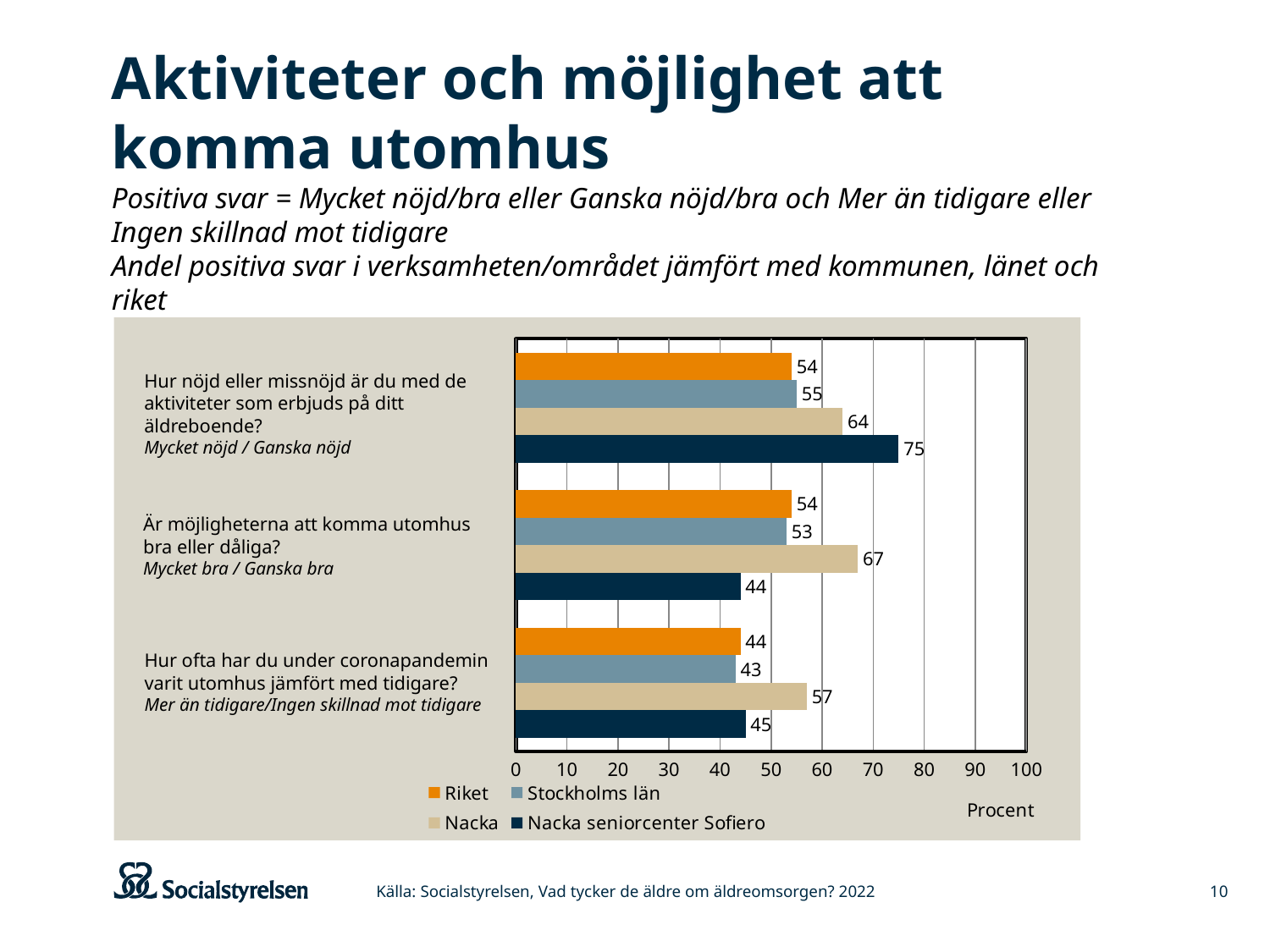
What is the value for Nacka seniorcenter Sofiero for the question "Hur nöjd eller missnöjd är du med de aktiviteter som erbjuds på ditt äldreboende?"? 75 How many question categories are plotted on the chart? 3 What is the value for Stockholms län for the question "Hur ofta har du under coronapandemin varit utomhus jämfört med tidigare?"? 43 For the question "Är möjligheterna att komma utomhus bra eller dåliga?", which is larger: the value for Nacka or the value for Riket? Nacka What is the difference between Nacka and Nacka seniorcenter Sofiero for the question "Hur ofta har du under coronapandemin varit utomhus jämfört med tidigare?"? 12 Which series has the lowest value for the question "Är möjligheterna att komma utomhus bra eller dåliga?"? Nacka seniorcenter Sofiero What kind of chart is shown on the slide? Bar chart What is the label of the x axis on the chart? Procent How many series does the legend list? 4 What is the value for Nacka for the question "Är möjligheterna att komma utomhus bra eller dåliga?"? 67 Which series has the highest value for the question "Hur nöjd eller missnöjd är du med de aktiviteter som erbjuds på ditt äldreboende?"? Nacka seniorcenter Sofiero What is the difference between Nacka seniorcenter Sofiero and Riket for the question "Hur nöjd eller missnöjd är du med de aktiviteter som erbjuds på ditt äldreboende?"? 21